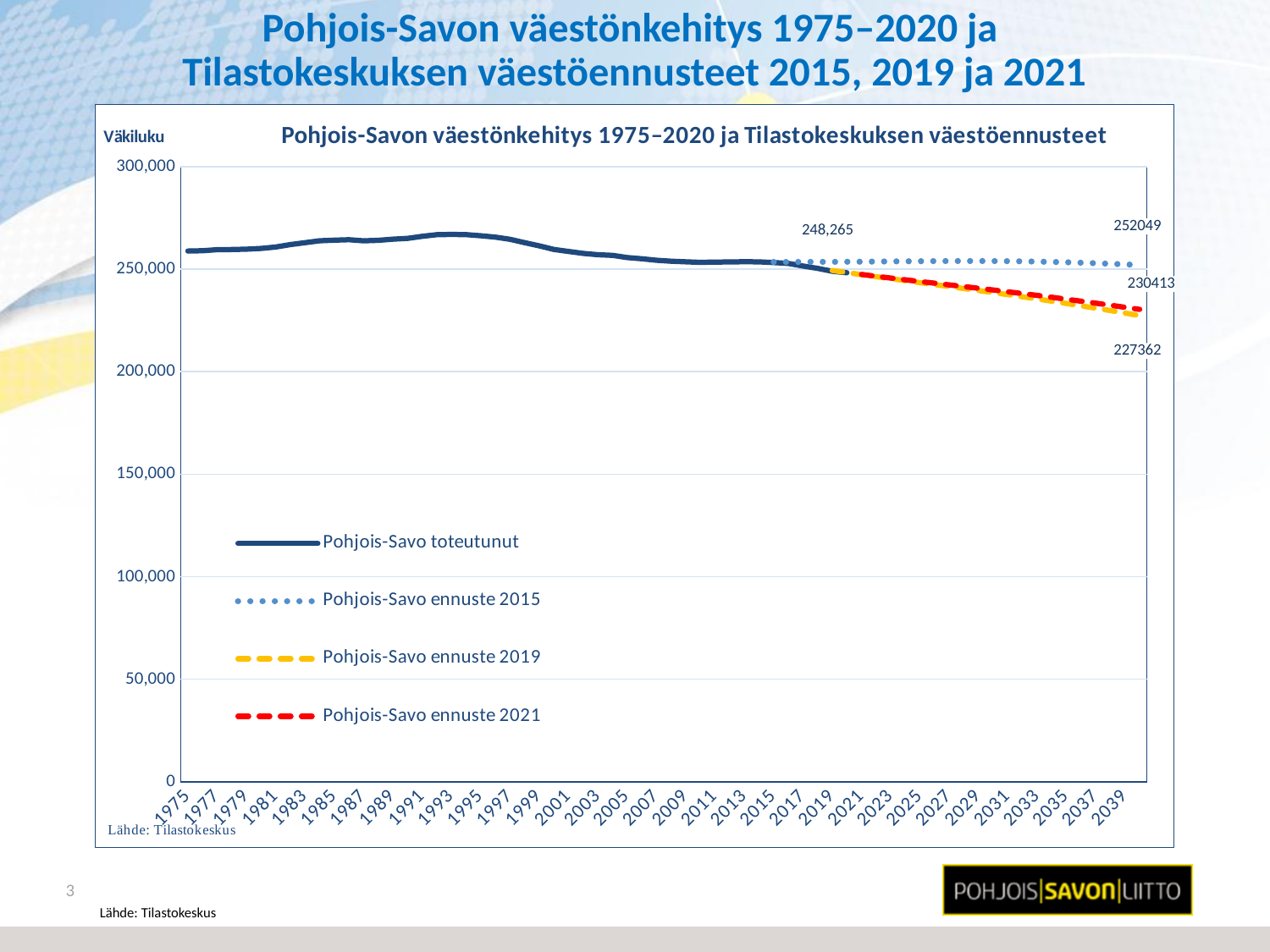
What is the data label shown at the end of the Pohjois-Savo toteutunut line? 248,265 What is the difference between the end values of Pohjois-Savo ennuste 2015 (252049) and Pohjois-Savo ennuste 2019 (227362)? 24687 Which forecast series ends at the lowest value? Pohjois-Savo ennuste 2019 Which forecast series ends at the highest value? Pohjois-Savo ennuste 2015 Which ends higher, Pohjois-Savo ennuste 2021 or Pohjois-Savo ennuste 2019? Pohjois-Savo ennuste 2021 Is the value of Pohjois-Savo toteutunut in 1993 greater or less than 250,000? greater Does the Pohjois-Savo ennuste 2021 line rise or fall from 2021 to 2040? Fall What is the data label shown at the end of the Pohjois-Savo ennuste 2021 line? 230413 What is the data label shown at the end of the Pohjois-Savo ennuste 2015 line? 252049 What kind of chart is shown on the slide? Line chart How many series does the legend list? 4 What is the data label shown at the end of the Pohjois-Savo ennuste 2019 line? 227362